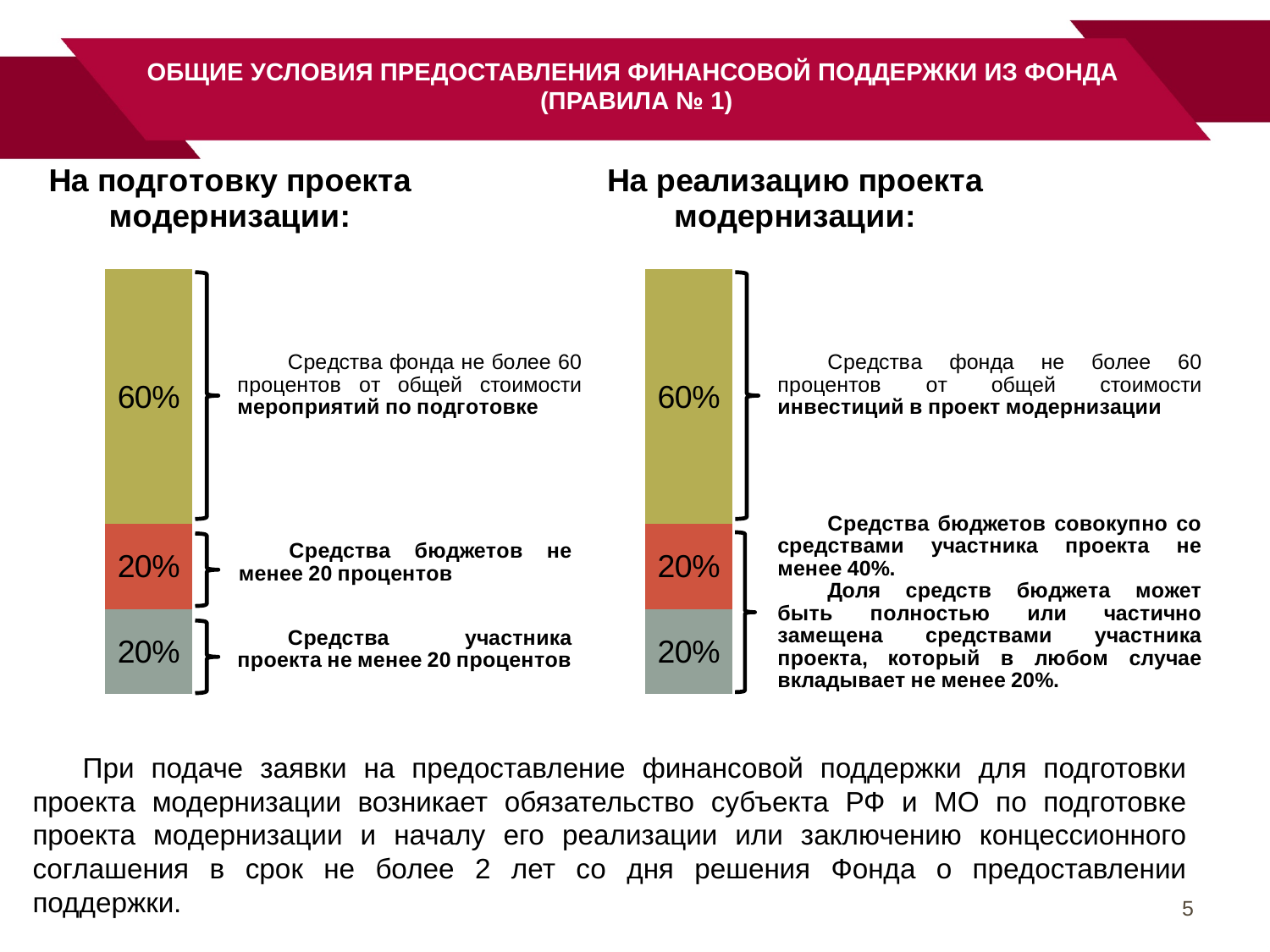
In the left chart 'На подготовку проекта модернизации', what is the total of all segments of the stacked bar? 100% In the right chart 'На реализацию проекта модернизации', what share is shown for the project participant's contribution (Средства участника проекта)? 20% In the left chart 'На подготовку проекта модернизации', what is the difference between the fund's share and the budgets' share? 40% In the right chart 'На реализацию проекта модернизации', which segment is the largest? Средства фонда (60%) In the right chart 'На реализацию проекта модернизации', which is larger: the fund's share or the participant's share? The fund's share (60%) In the left chart 'На подготовку проекта модернизации', what share is shown for the fund's contribution (Средства фонда)? 60% How many stacked bar charts are shown on the slide? 2 In the left chart 'На подготовку проекта модернизации', what share is shown for the budgets' contribution (Средства бюджетов)? 20% What type of chart is used on the left under 'На подготовку проекта модернизации'? Stacked bar chart In the right chart 'На реализацию проекта модернизации', what is the combined share of the budgets' and the participant's segments? 40% In the left chart 'На подготовку проекта модернизации', what colour is the segment representing the fund's 60% share? Olive/yellow How many segments does the stacked bar in the left chart 'На подготовку проекта модернизации' have? 3